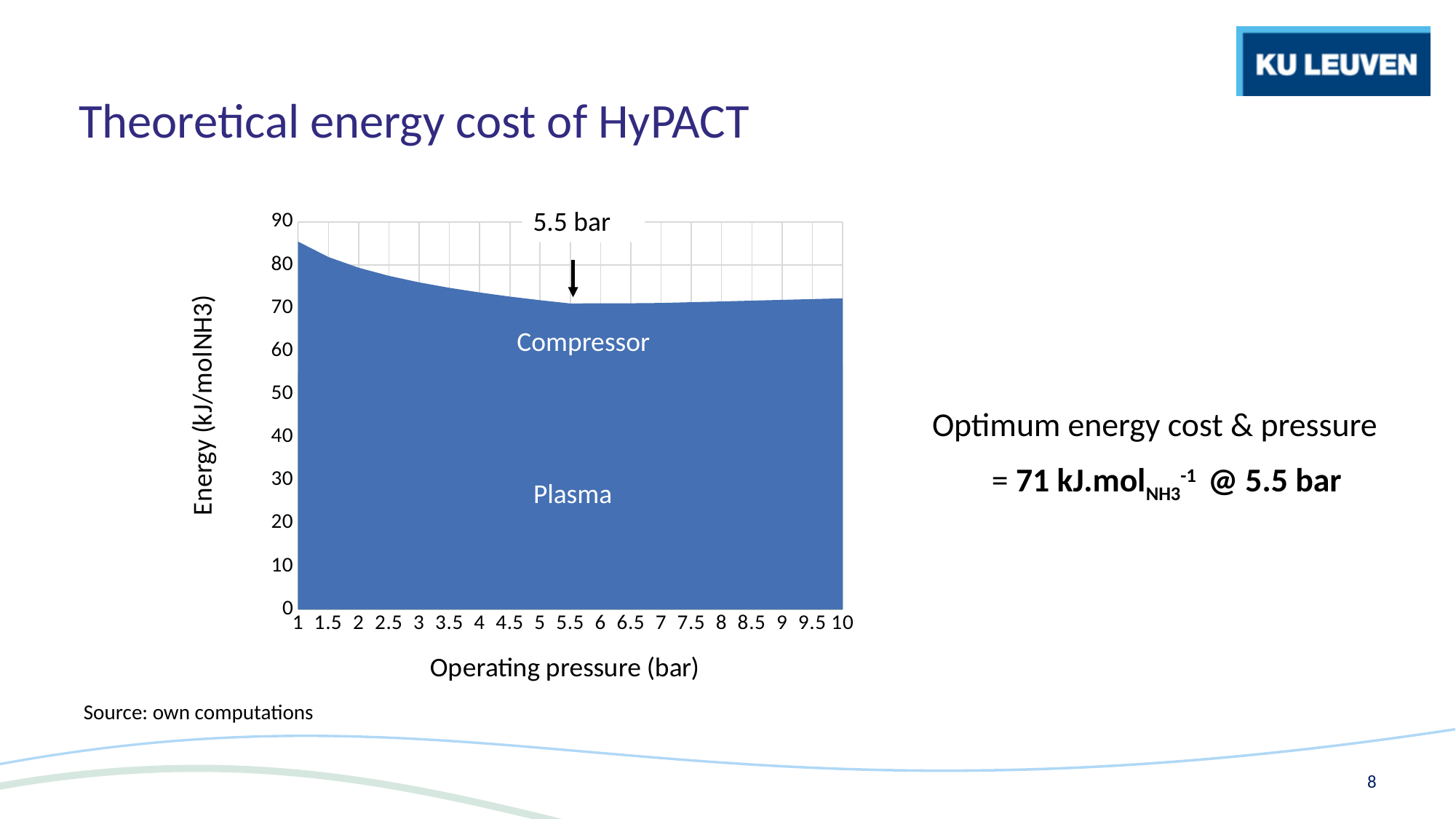
Is the energy value at 1 bar greater or less than 80? greater Is the energy value at 5.5 bar greater or less than 60? greater Does the energy cost rise or fall as operating pressure increases from 1 bar to 5.5 bar? fall At which operating pressure is the energy cost highest? 1 bar Is the energy value at 10 bar greater or less than 80? less What kind of chart is shown on the slide? area chart How many operating pressure tick labels are shown on the x axis? 19 What are the two components labelled inside the shaded area of the chart? Compressor and Plasma According to the slide, what is the optimum energy cost in kJ per mol NH3? 71 At which operating pressure does the energy cost reach its minimum, as marked by the arrow on the chart? 5.5 bar Which has a higher energy cost: 3 bar or 8 bar? 3 bar Which has a higher energy cost: 1 bar or 10 bar? 1 bar